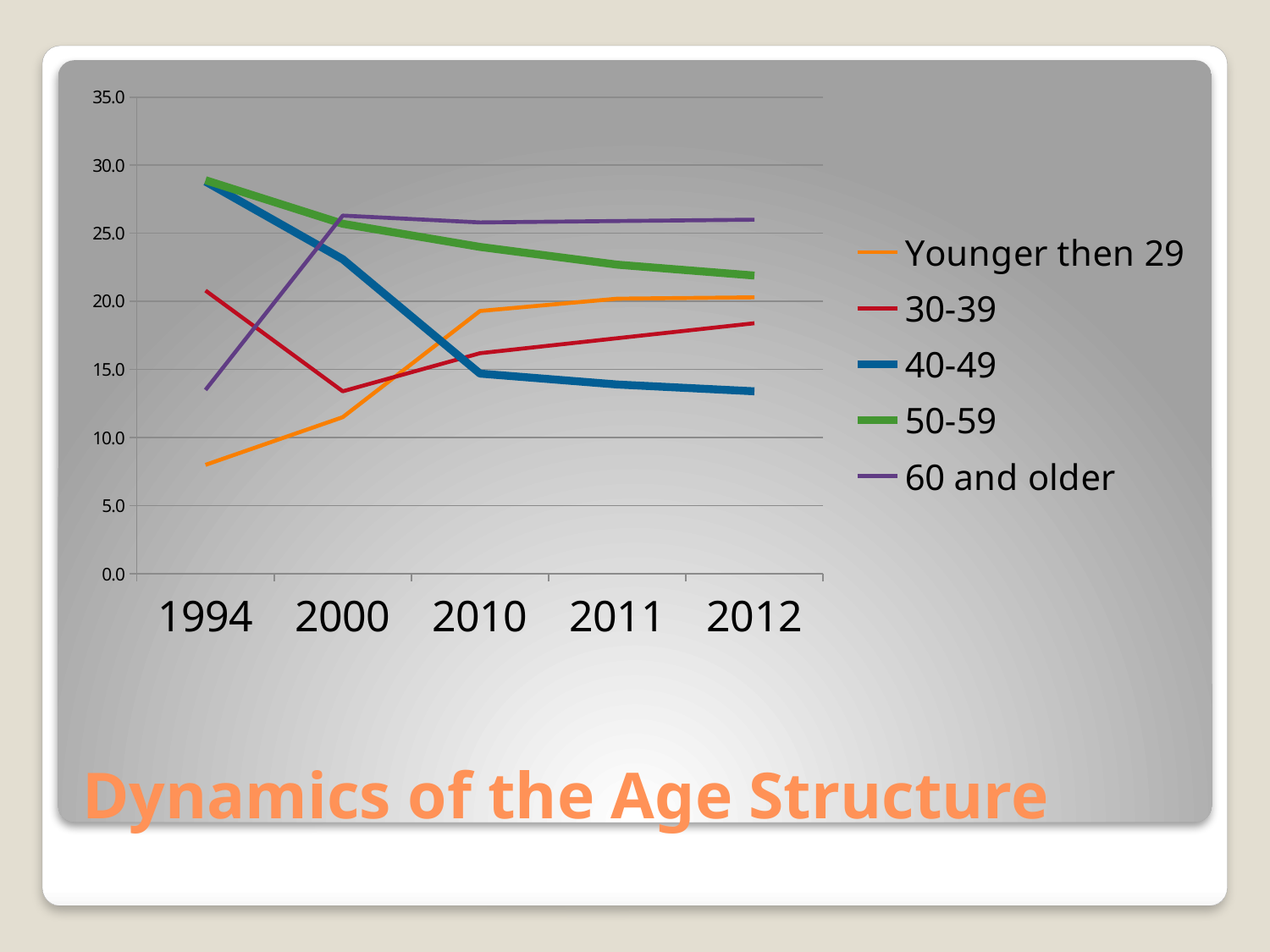
Is the value for 'Younger then 29' in 1994 greater or less than 10.0? less Is the value for '40-49' in 2012 greater or less than 15.0? less How many series does the legend list? 5 What kind of chart is shown on the slide? line chart Is the value for '50-59' in 1994 greater or less than 25.0? greater Does the value for '40-49' rise or fall from 1994 to 2012? fall What is the title of the slide containing the chart? Dynamics of the Age Structure How many years are shown on the x axis? 5 Does the value for 'Younger then 29' rise or fall from 1994 to 2012? rise Which series has the lowest value in 1994? Younger then 29 Which series has the highest value in 2012? 60 and older Which series is drawn with the blue line? 40-49